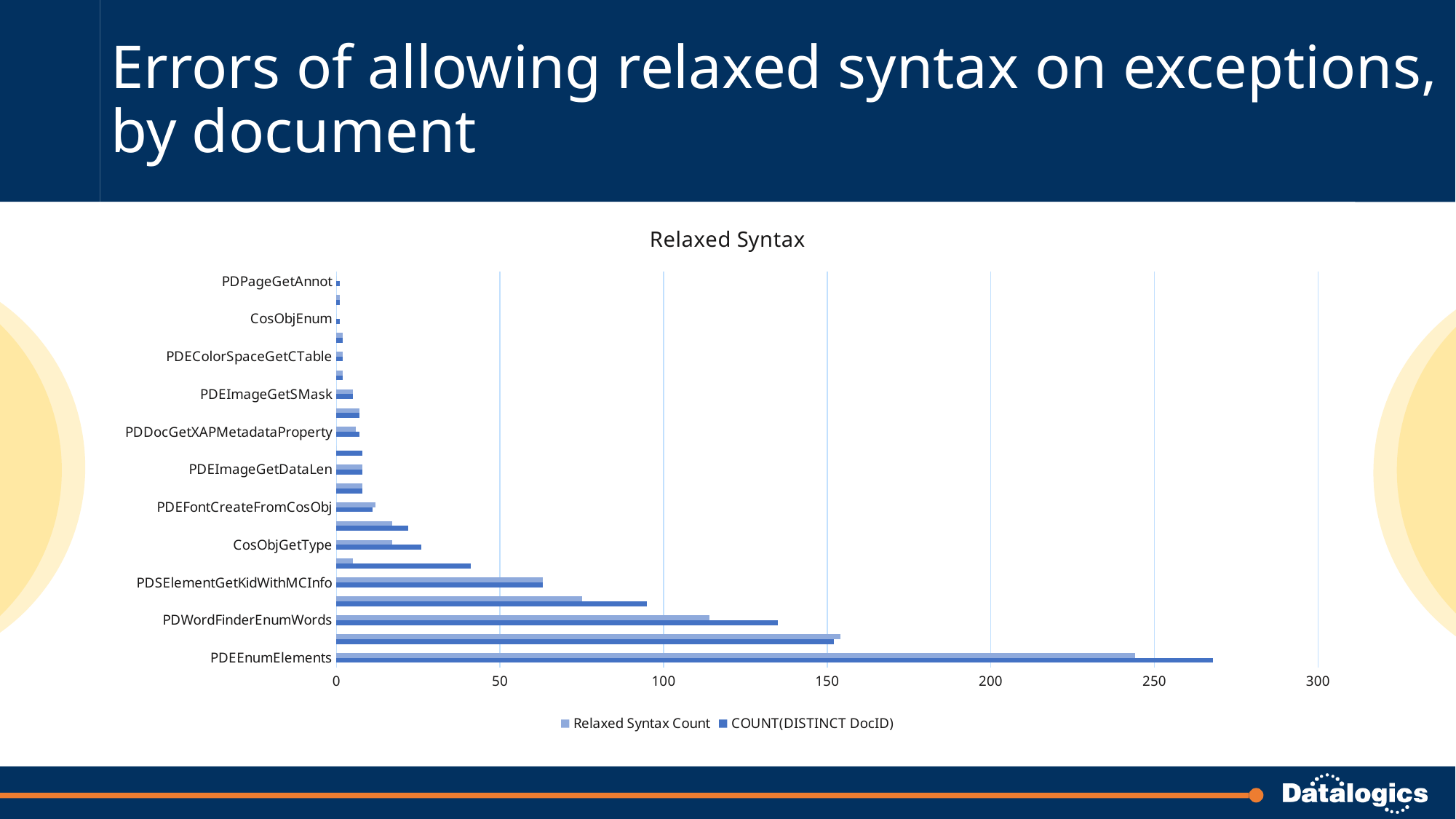
Is the COUNT(DISTINCT DocID) value for CosObjGetType greater or less than 50? less What is the title of the chart? Relaxed Syntax Which category has a larger COUNT(DISTINCT DocID): PDWordFinderEnumWords or PDSElementGetKidWithMCInfo? PDWordFinderEnumWords Which category has the highest COUNT(DISTINCT DocID) value? PDEEnumElements Is the COUNT(DISTINCT DocID) value for PDWordFinderEnumWords greater or less than 100? greater What are the two series named in the legend? Relaxed Syntax Count and COUNT(DISTINCT DocID) How many series does the legend list? 2 Is the COUNT(DISTINCT DocID) value for PDEEnumElements greater or less than 250? greater Which category has the highest Relaxed Syntax Count value? PDEEnumElements Which is larger for PDEEnumElements: the Relaxed Syntax Count or the COUNT(DISTINCT DocID)? COUNT(DISTINCT DocID) What kind of chart is shown on the slide? bar chart